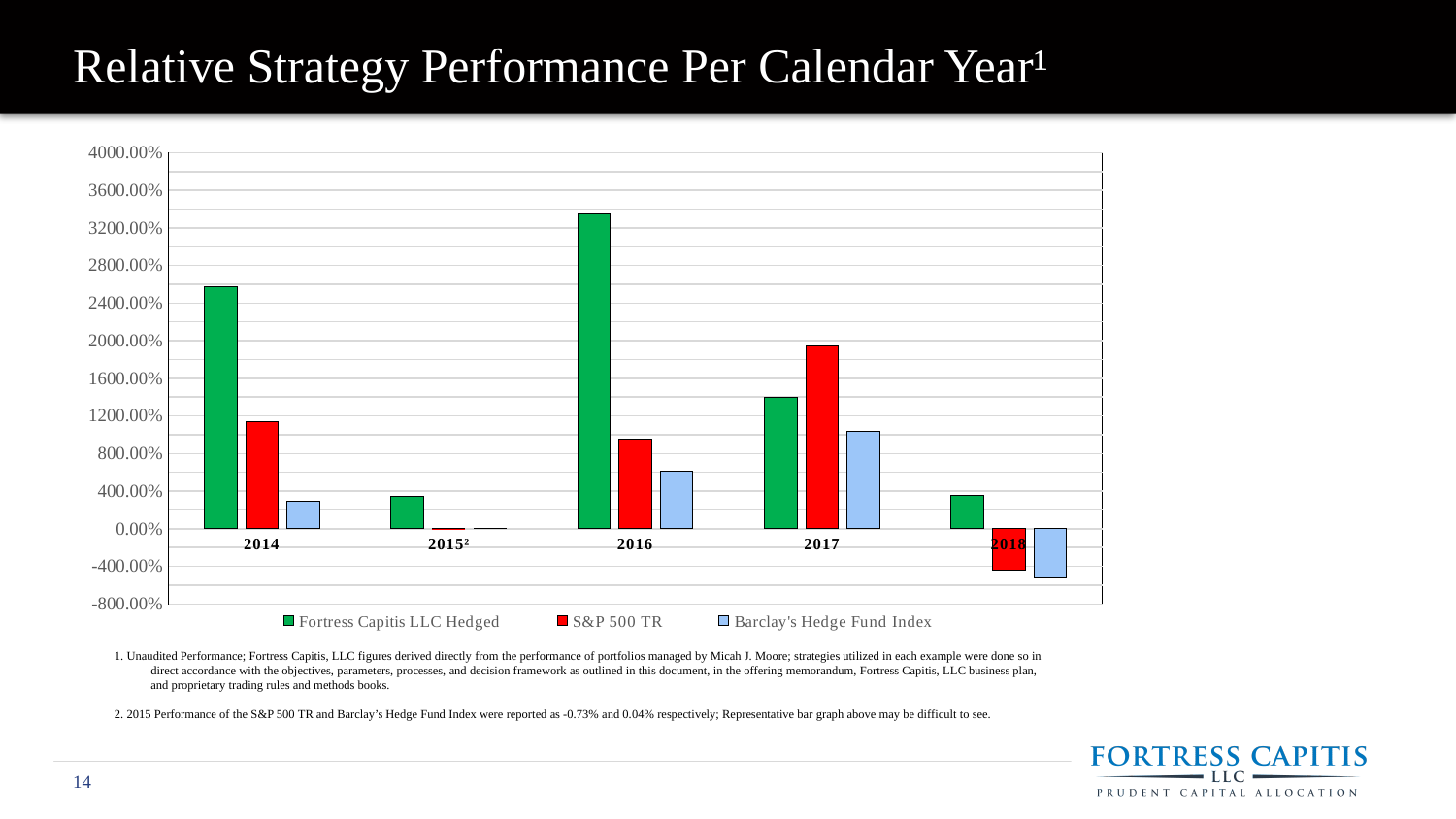
In which year is the Fortress Capitis LLC Hedged value highest? 2016 How many series does the legend list? 3 How many calendar years are shown on the x axis? 5 Is the Barclay's Hedge Fund Index value for 2016 greater or less than 800.00%? less Is the Fortress Capitis LLC Hedged value for 2016 greater or less than 3200.00%? greater According to the footnote, what was the 2015 performance of Barclay's Hedge Fund Index? 0.04% In 2017, which is larger: Fortress Capitis LLC Hedged or S&P 500 TR? S&P 500 TR In which year is the Barclay's Hedge Fund Index value lowest? 2018 According to the footnote, what was the 2015 performance of the S&P 500 TR? -0.73% What kind of chart is shown on the slide? bar chart Does the S&P 500 TR value rise or fall from 2015 to 2017? rise In which year is the S&P 500 TR value highest? 2017